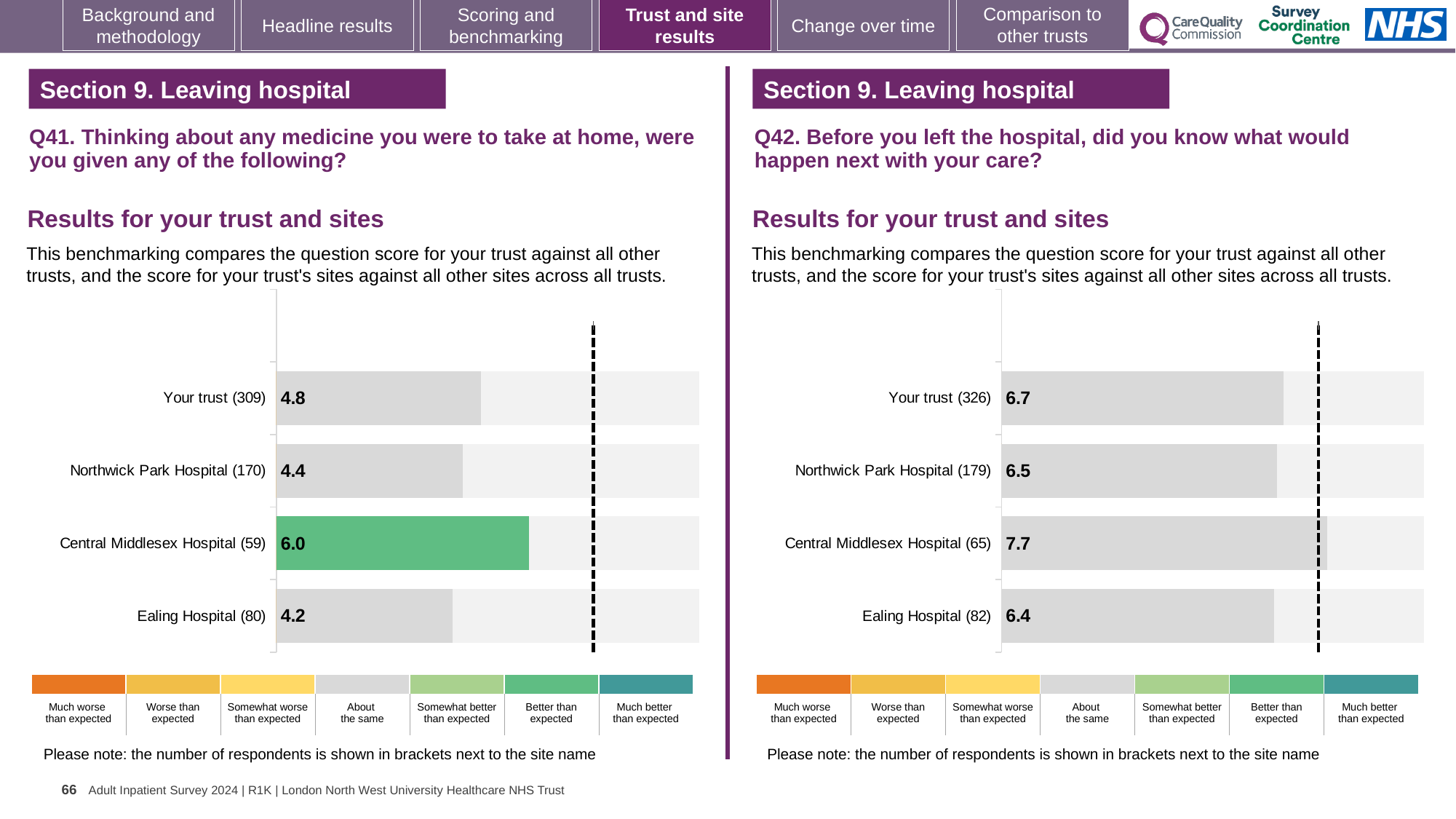
In the Q42 chart on the right, which site or trust has the lowest score? Ealing Hospital In the Q42 chart on the right, what is the score for Central Middlesex Hospital? 7.7 In the Q41 chart on the left, what is the difference between the scores for Central Middlesex Hospital and Northwick Park Hospital? 1.6 In the Q41 chart on the left, which site or trust has the lowest score? Ealing Hospital In the Q41 chart on the left, which site or trust has the highest score? Central Middlesex Hospital In the Q41 chart on the left, how many bars are plotted? 4 In the Q42 chart on the right, what is the score for Northwick Park Hospital? 6.5 In the Q41 chart on the left, what is the score for Ealing Hospital? 4.2 What kind of chart is used on the right for Q42? Bar chart In the Q41 chart on the left, what is the score for Your trust? 4.8 In the Q41 chart on the left, which bar is coloured green rather than grey? Central Middlesex Hospital In the Q42 chart on the right, which is larger: the score for Your trust or the score for Ealing Hospital? Your trust